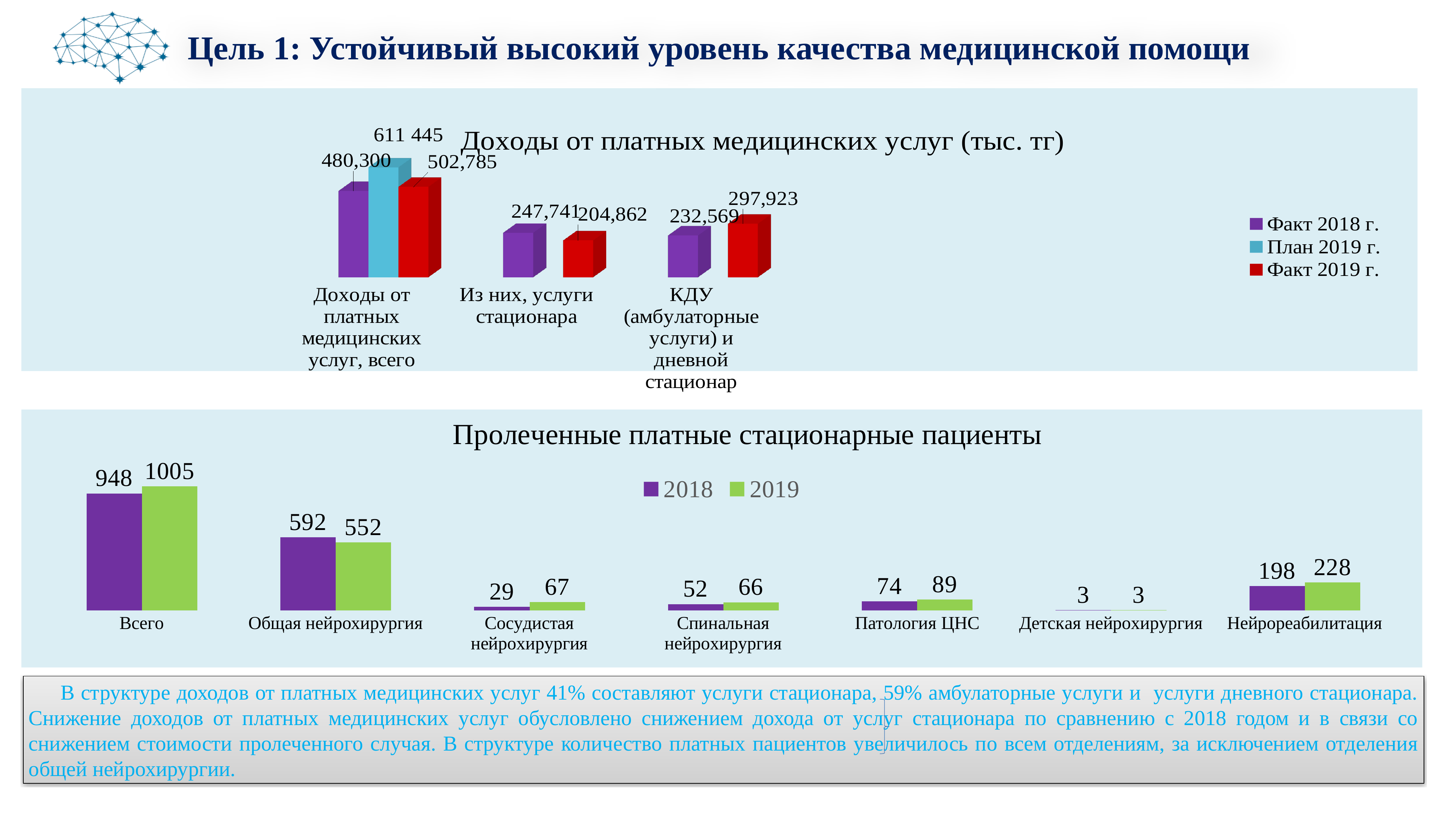
In the chart 'Доходы от платных медицинских услуг (тыс. тг)', which is larger for 'КДУ (амбулаторные услуги) и дневной стационар': 'Факт 2018 г.' or 'Факт 2019 г.'? Факт 2019 г. In the chart 'Доходы от платных медицинских услуг (тыс. тг)', what is the value of 'План 2019 г.' for 'Доходы от платных медицинских услуг, всего'? 611 445 In the chart 'Доходы от платных медицинских услуг (тыс. тг)', what is the 'Факт 2019 г.' value for 'Из них, услуги стационара'? 204,862 In the chart 'Доходы от платных медицинских услуг (тыс. тг)', how many series does the legend list? 3 In the chart 'Пролеченные платные стационарные пациенты', what is the 2018 value for 'Сосудистая нейрохирургия'? 29 In the chart 'Доходы от платных медицинских услуг (тыс. тг)', what is the difference between 'Факт 2018 г.' and 'Факт 2019 г.' for 'Из них, услуги стационара'? 42,879 In the chart 'Пролеченные платные стационарные пациенты', what is the 2019 value for 'Нейрореабилитация'? 228 In the chart 'Пролеченные платные стационарные пациенты', how many categories are shown on the x axis? 7 In the chart 'Пролеченные платные стационарные пациенты', what is the difference between the 2019 and 2018 values for 'Всего'? 57 What kind of chart is 'Пролеченные платные стационарные пациенты'? Bar chart In the chart 'Пролеченные платные стационарные пациенты', which category has the lowest 2018 value? Детская нейрохирургия In the chart 'Пролеченные платные стационарные пациенты', which is larger for 'Общая нейрохирургия': the 2018 value or the 2019 value? 2018